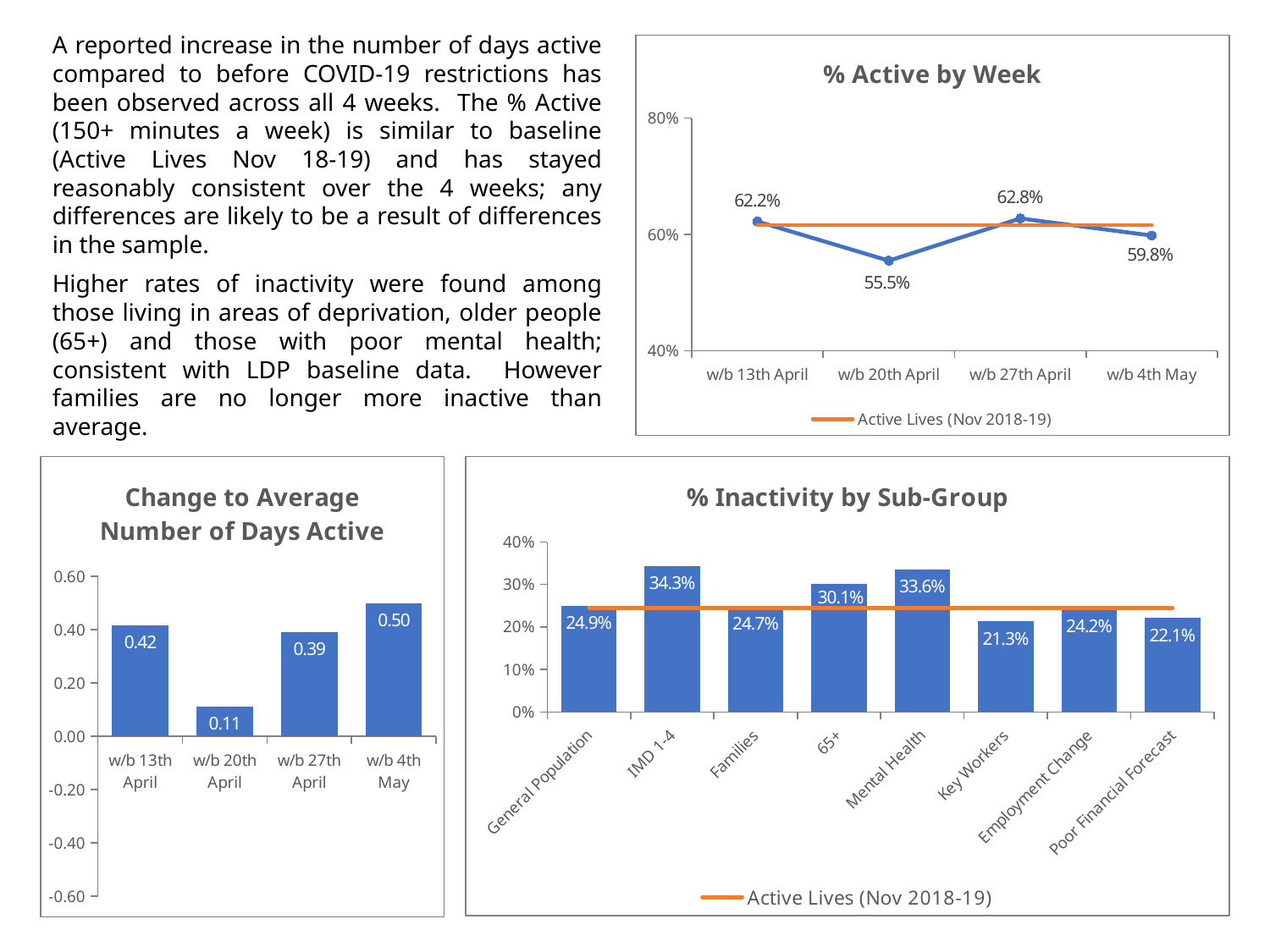
In the '% Active by Week' chart, which week has the highest % active? w/b 27th April In the '% Inactivity by Sub-Group' chart, which sub-group has the lowest inactivity? Key Workers What kind of chart is the '% Active by Week' chart? Line chart In the 'Change to Average Number of Days Active' chart, how many weeks are plotted? 4 In the '% Inactivity by Sub-Group' chart, how many sub-groups are shown? 8 In the '% Inactivity by Sub-Group' chart, what is the value for Mental Health? 33.6% In the '% Active by Week' chart, what is the difference between w/b 13th April and w/b 4th May? 2.4% In the '% Inactivity by Sub-Group' chart, what does the orange line in the legend represent? Active Lives (Nov 2018-19) In the '% Inactivity by Sub-Group' chart, which is larger, IMD 1-4 or 65+? IMD 1-4 In the 'Change to Average Number of Days Active' chart, which week has the highest value? w/b 4th May In the '% Active by Week' chart, what is the value for w/b 20th April? 55.5% In the 'Change to Average Number of Days Active' chart, what is the value for w/b 20th April? 0.11